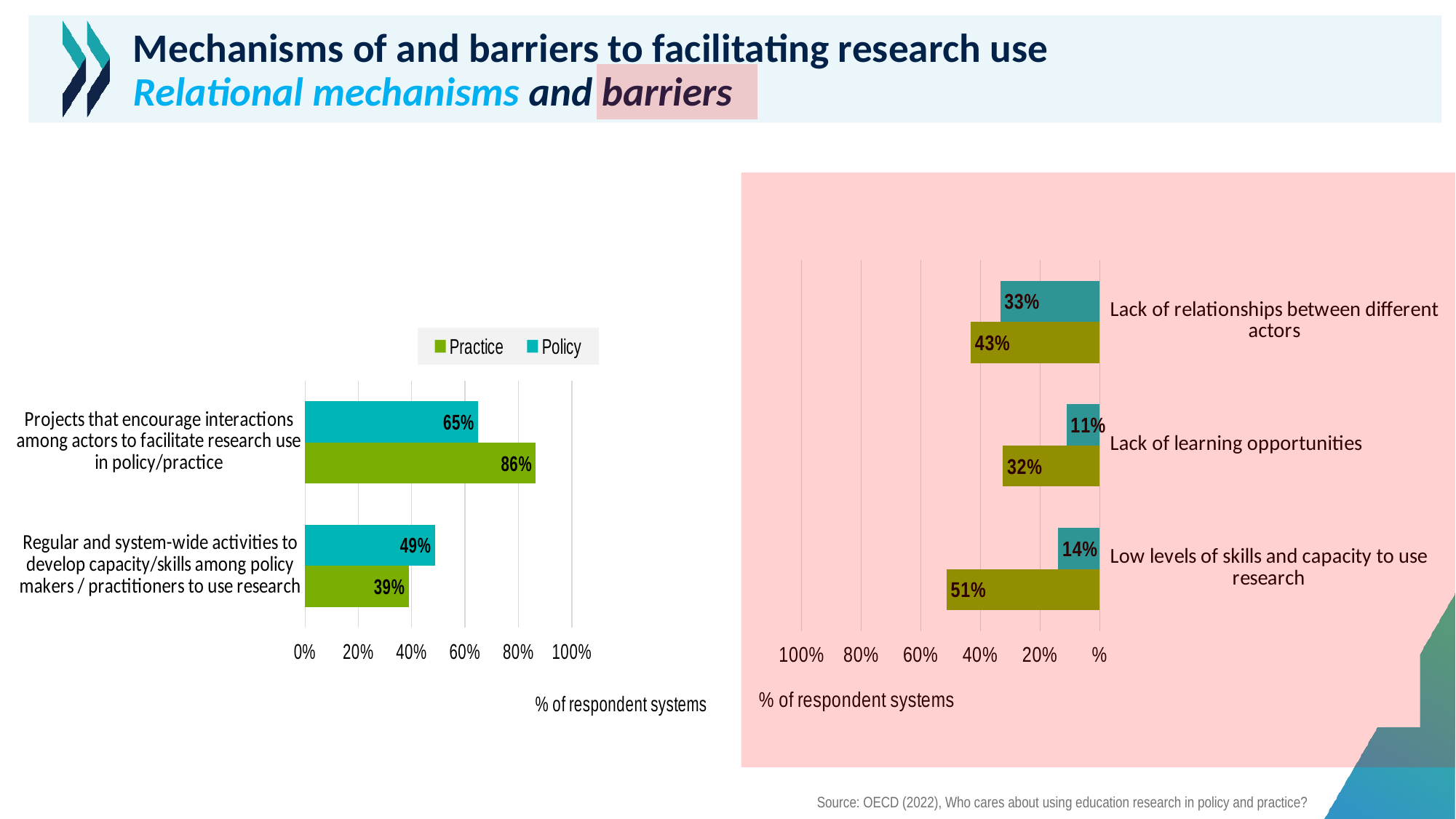
On the right chart, what is the value of the teal bar for 'Lack of learning opportunities'? 11% On the right chart, which category has the highest green bar value? Low levels of skills and capacity to use research How many categories are shown on the right chart? 3 On the left chart, for 'Regular and system-wide activities to develop capacity/skills among policy makers / practitioners to use research', which series has the larger value, Practice or Policy? Policy On the left chart, what is the difference between the Practice and Policy values for 'Projects that encourage interactions among actors to facilitate research use in policy/practice'? 21% On the left chart, what is the Practice value for 'Projects that encourage interactions among actors to facilitate research use in policy/practice'? 86% On the right chart, what is the value of the green bar for 'Low levels of skills and capacity to use research'? 51% How many series does the legend on the left chart list? 2 On the right chart, what is the difference between the green and teal bar values for 'Lack of relationships between different actors'? 10% What type of chart is the left chart? Bar chart On the left chart, what is the Policy value for 'Regular and system-wide activities to develop capacity/skills among policy makers / practitioners to use research'? 49% On the right chart, which category has the lowest teal bar value? Lack of learning opportunities